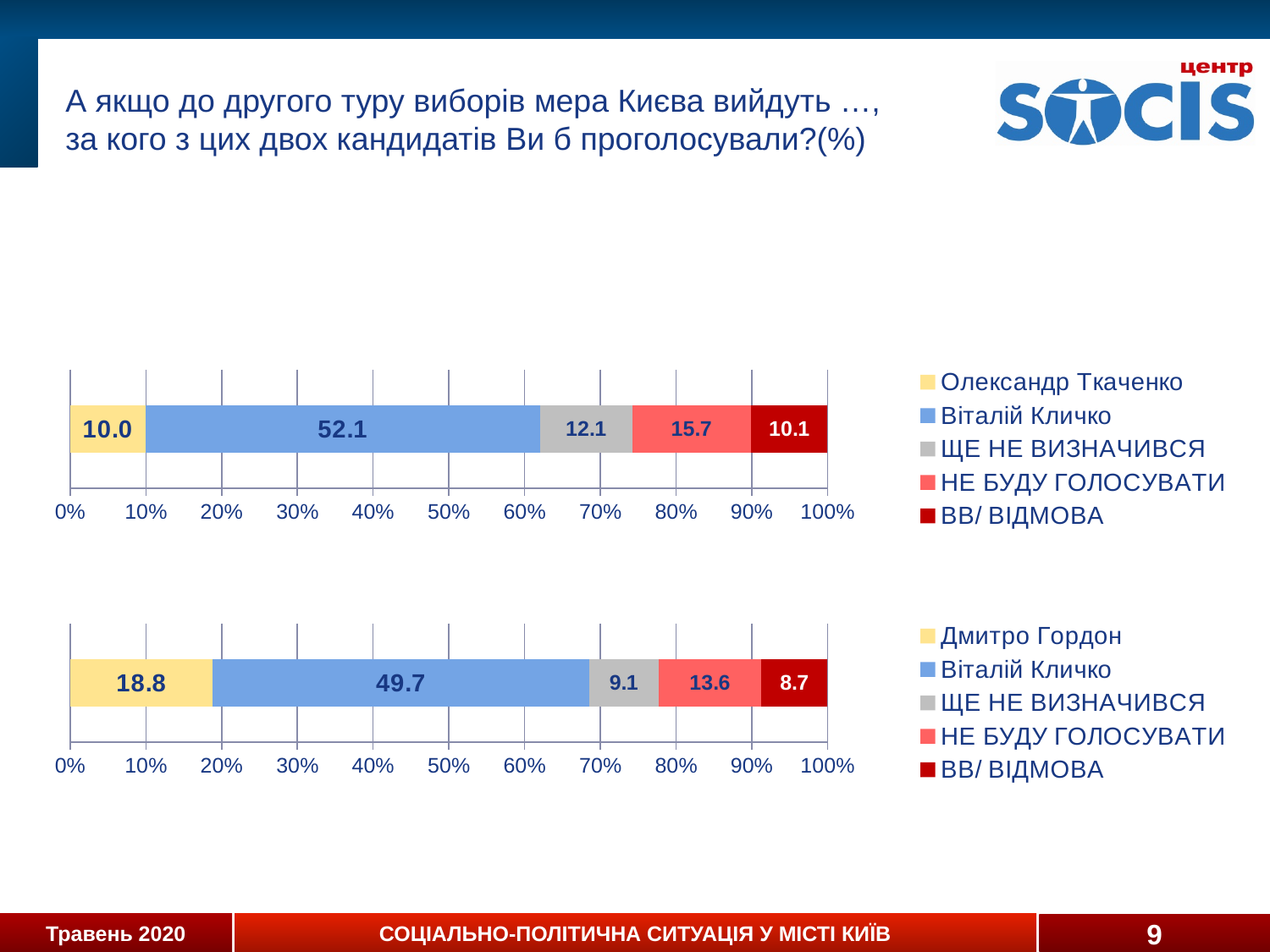
In the top chart, which is larger: the value for НЕ БУДУ ГОЛОСУВАТИ or the value for ЩЕ НЕ ВИЗНАЧИВСЯ? НЕ БУДУ ГОЛОСУВАТИ In the top chart, which legend entry has the largest value? Віталій Кличко In the bottom chart, what is the value for Дмитро Гордон? 18.8 In the top chart, what is the value for Олександр Ткаченко? 10.0 In the bottom chart, what is the difference between the values for Віталій Кличко and Дмитро Гордон? 30.9 In the bottom chart, what is the value for НЕ БУДУ ГОЛОСУВАТИ? 13.6 In the bottom chart, which legend entry has the smallest value? ВВ/ ВІДМОВА What kind of chart is the top chart? Stacked bar chart In the top chart, what is the value for Віталій Кличко? 52.1 In the top chart, what is the total of all segments in the bar? 100.0 In the top chart, what colour is the segment for Віталій Кличко? Blue How many series does the legend of the bottom chart list? 5